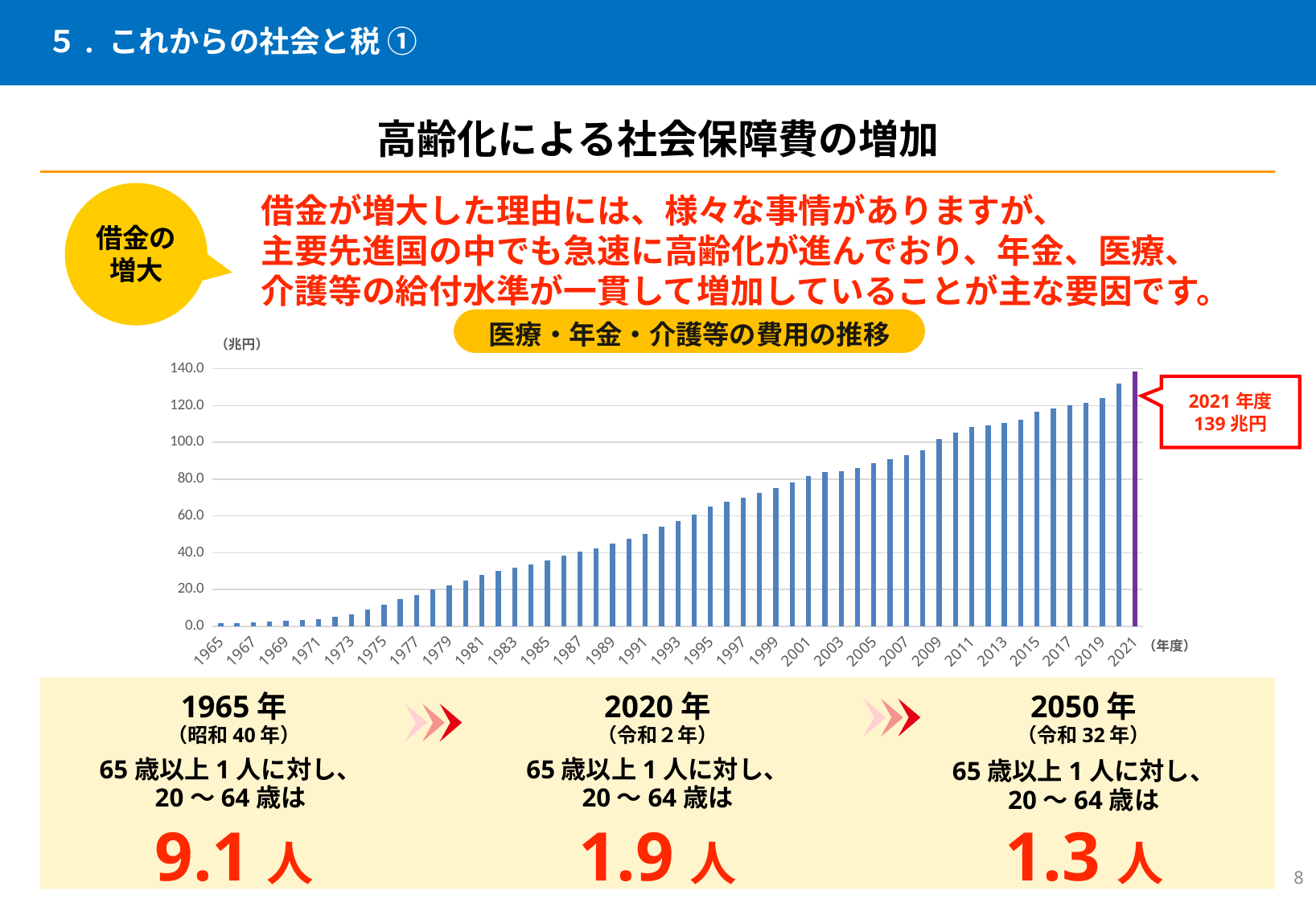
Do the values in the chart rise or fall from 1965 to 2021? rise What is the value shown for fiscal year 2021 in the 医療・年金・介護等の費用の推移 chart? 139兆円 Which year has the lowest value in the chart? 1965 What unit is shown on the vertical axis of the chart? 兆円 What is the title of the chart? 医療・年金・介護等の費用の推移 Is the value for 2001 greater or less than 60.0? greater What kind of chart is shown on the slide? bar chart Is the value for 2013 greater or less than 100.0? greater Is the value for 1975 greater or less than 20.0? less Which year has the highest value in the chart? 2021 Which is larger, the value for 1991 or the value for 2009? 2009